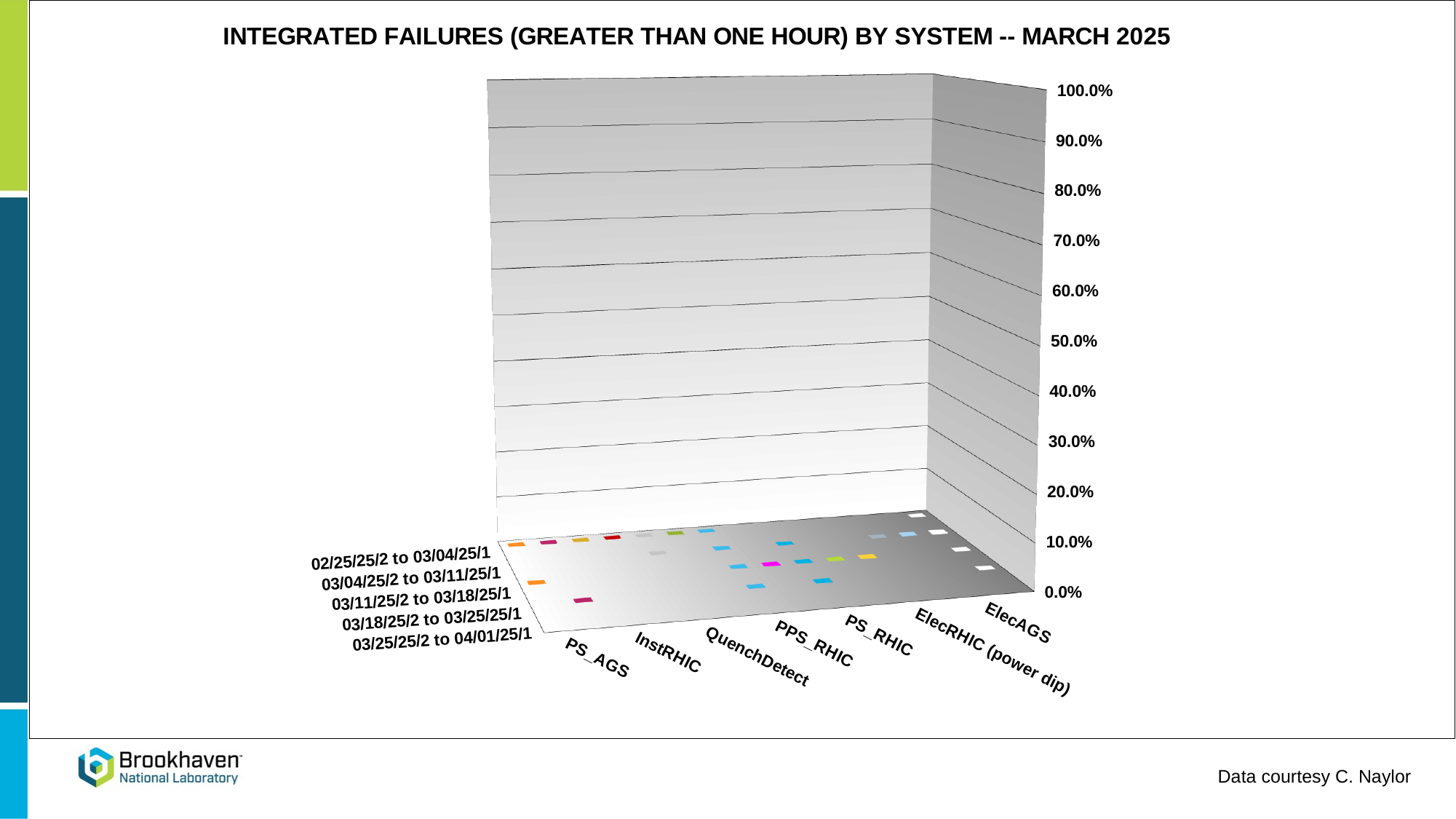
Is the value for PS_AGS in the 02/25/25/2 to 03/04/25/1 period greater or less than 10.0%? less Which system category is listed first (leftmost) on the horizontal axis? PS_AGS What is the title of the chart? INTEGRATED FAILURES (GREATER THAN ONE HOUR) BY SYSTEM -- MARCH 2025 What kind of chart is shown on the slide? bar chart How many date-range series are listed along the depth axis of the chart? 5 What is the highest value shown on the vertical axis of the chart? 100.0% Is the value for PPS_RHIC in the 02/25/25/2 to 03/04/25/1 period greater or less than 10.0%? less How many system categories are listed along the horizontal axis of the chart? 7